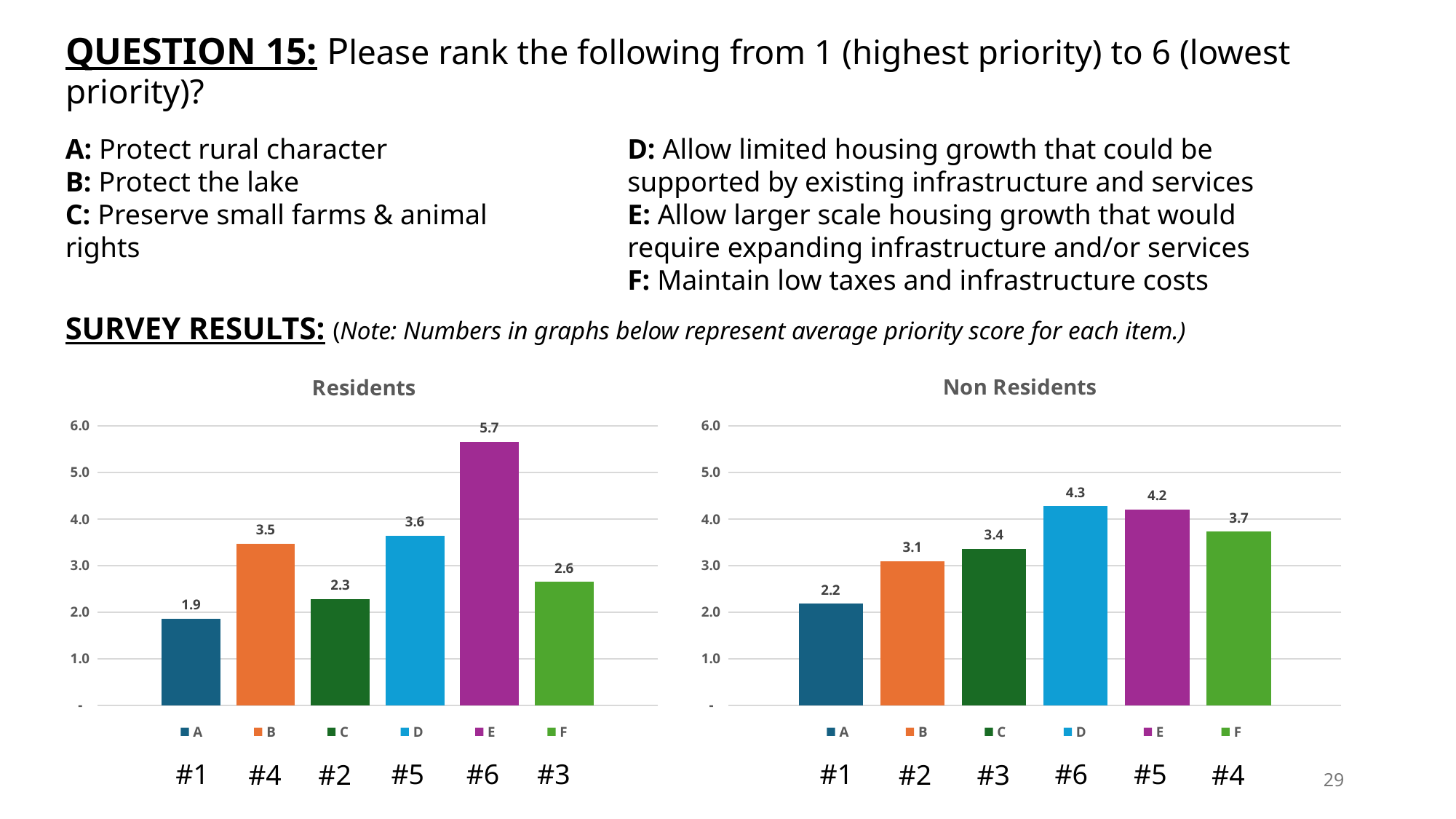
In the Residents chart, what is the difference between the scores for item E and item A? 3.8 In the Non Residents chart, what is the average priority score for item D? 4.3 What is the title of the chart on the right side of the slide? Non Residents How many bars are shown in the Residents chart? 6 In the Residents chart, which has a higher score, item B or item F? B In the Residents chart, what is the average priority score for item E? 5.7 How many series does the legend of the Non Residents chart list? 6 What type of chart is the Residents chart? Bar chart In the Non Residents chart, which item has the highest average priority score? D In the Non Residents chart, what is the difference between the scores for item F and item B? 0.6 In the Residents chart, which item has the lowest average priority score? A In the Non Residents chart, is the value for item C greater or less than 3.0? greater